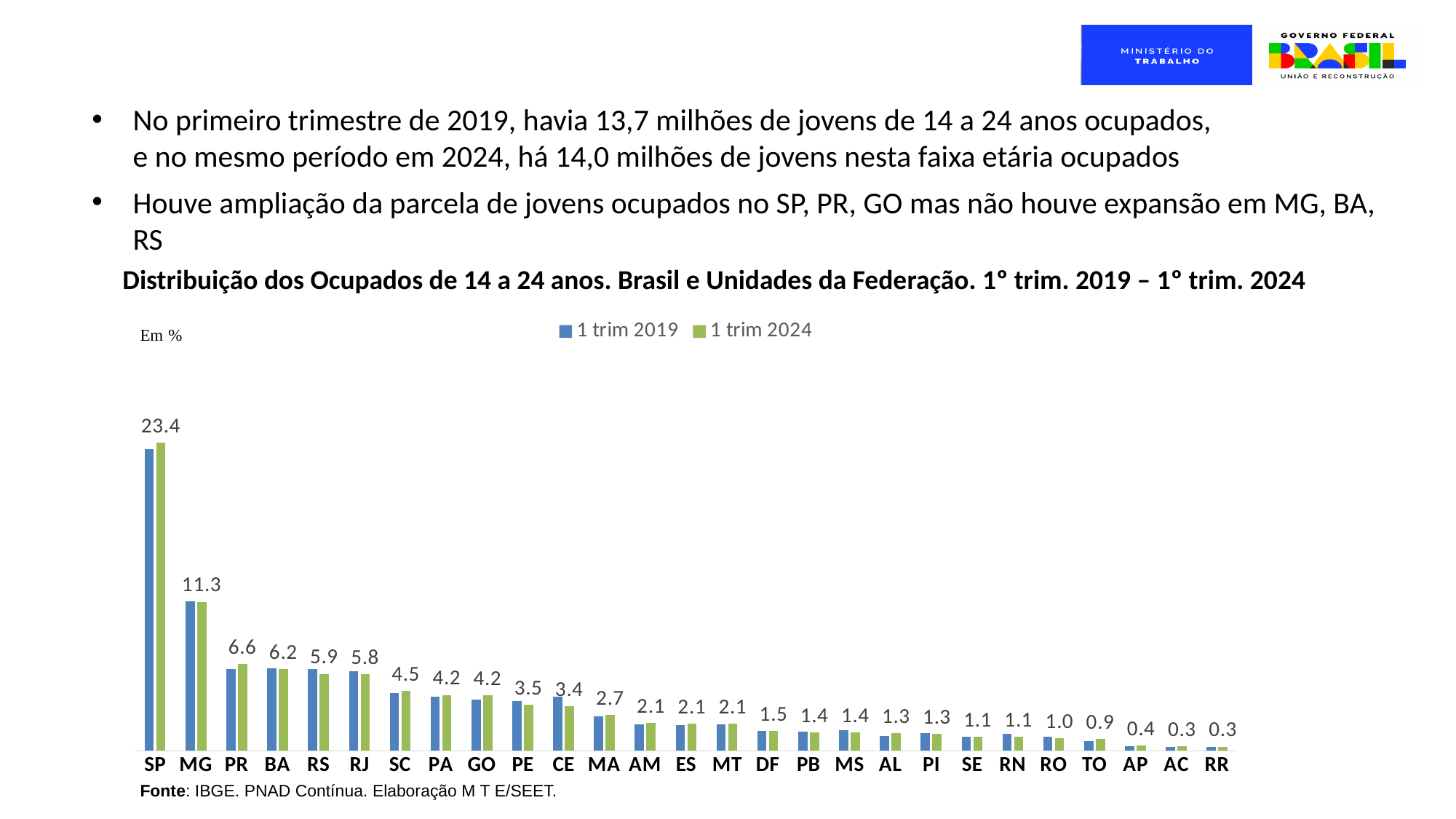
How many series does the chart legend list? 2 What is the difference between the labelled values for SP and MG? 12.1 How many states (categories) are shown on the x axis of the chart? 27 What value is labelled above the bars for RJ? 5.8 What kind of chart is shown on the slide? bar chart What value is labelled above the bars for PR? 6.6 Do the labelled values rise or fall moving from left to right along the x axis? fall What value is labelled above the bars for SP? 23.4 Which state has the highest share of occupied youths aged 14 to 24 in the chart? SP For SP, which series has the taller bar, 1 trim 2019 or 1 trim 2024? 1 trim 2024 What are the two series named in the chart legend? 1 trim 2019 and 1 trim 2024 What value is labelled above the bars for MG? 11.3